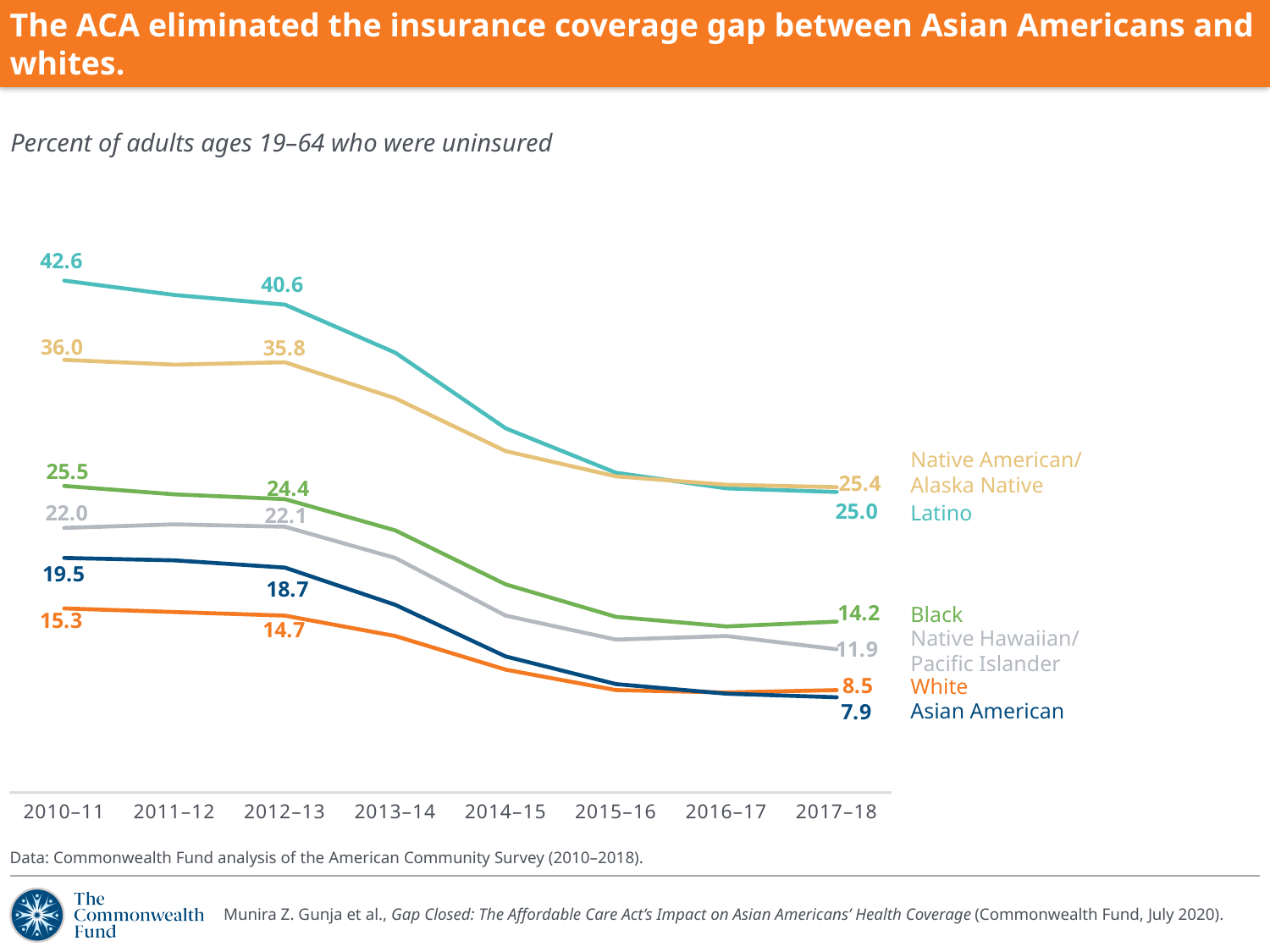
What type of chart is shown on the slide? line chart What was the uninsured rate for Asian American adults in 2017–18? 7.9 How many time periods are shown on the x axis? 8 Which group had the lowest uninsured rate in 2017–18? Asian American Which group had the highest uninsured rate in 2010–11? Latino How many groups (series) are plotted on the chart? 6 What was the uninsured rate for White adults in 2012–13? 14.7 Does the uninsured rate for Latino adults rise or fall from 2010–11 to 2017–18? fall In 2017–18, which group had a higher uninsured rate: Black or Native Hawaiian/Pacific Islander? Black What was the uninsured rate for Latino adults in 2010–11? 42.6 What was the uninsured rate for Native Hawaiian/Pacific Islander adults in 2017–18? 11.9 What is the difference between the Asian American uninsured rate in 2010–11 and in 2017–18? 11.6